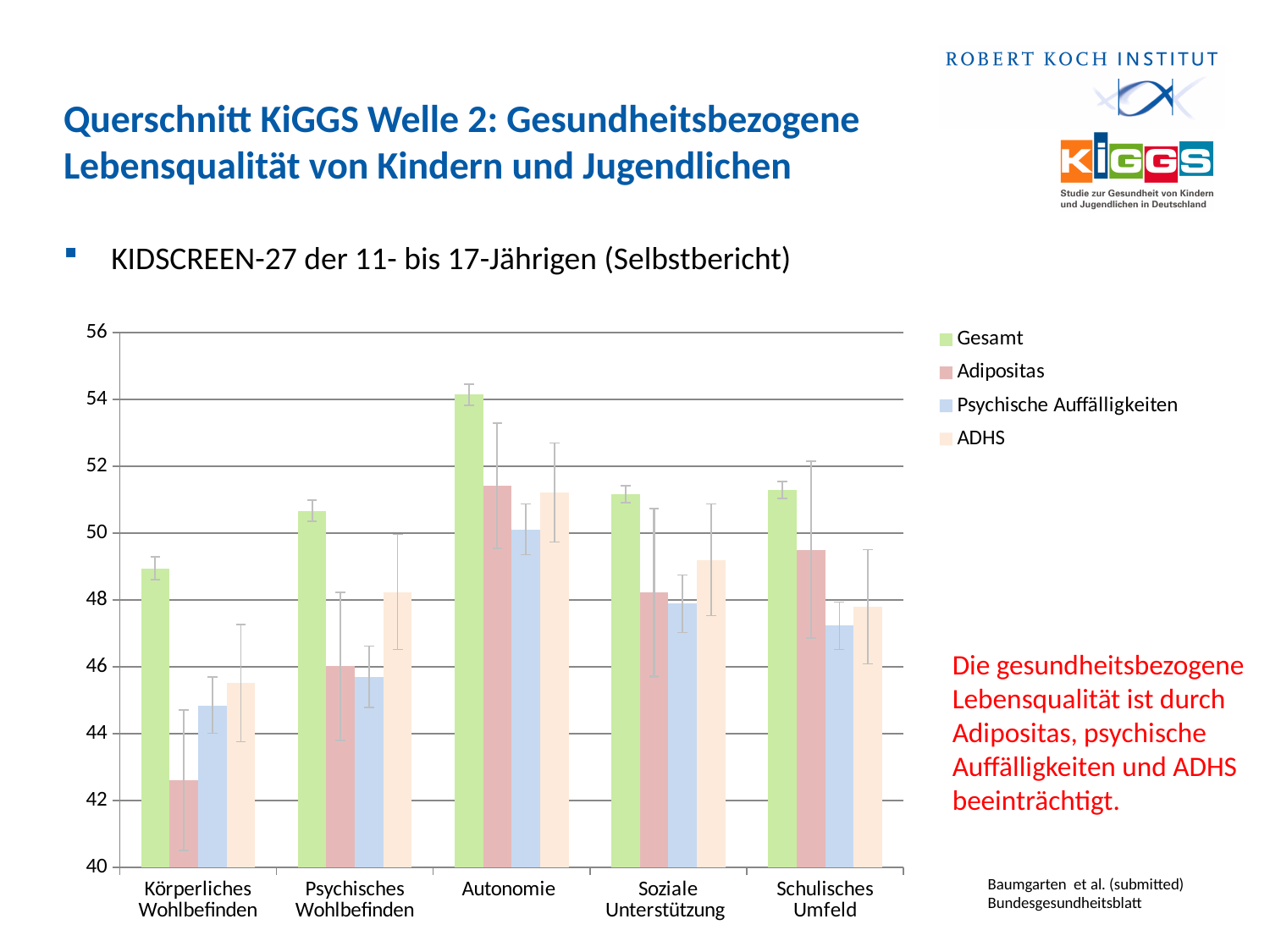
Is the Gesamt value for Autonomie greater or less than 52? greater Which colour represents the Gesamt series in the legend? green What kind of chart is shown on the slide? bar chart For Körperliches Wohlbefinden, which is larger: the Adipositas value or the ADHS value? ADHS In which category is the Adipositas bar lowest? Körperliches Wohlbefinden Is the Psychische Auffälligkeiten value for Autonomie greater or less than 48? greater For Schulisches Umfeld, which is larger: the Adipositas value or the Psychische Auffälligkeiten value? Adipositas In which category is the Gesamt bar highest? Autonomie Which series has the highest bar in the Körperliches Wohlbefinden category? Gesamt Is the Adipositas value for Körperliches Wohlbefinden greater or less than 44? less How many series does the legend list? 4 How many categories are shown on the x axis? 5